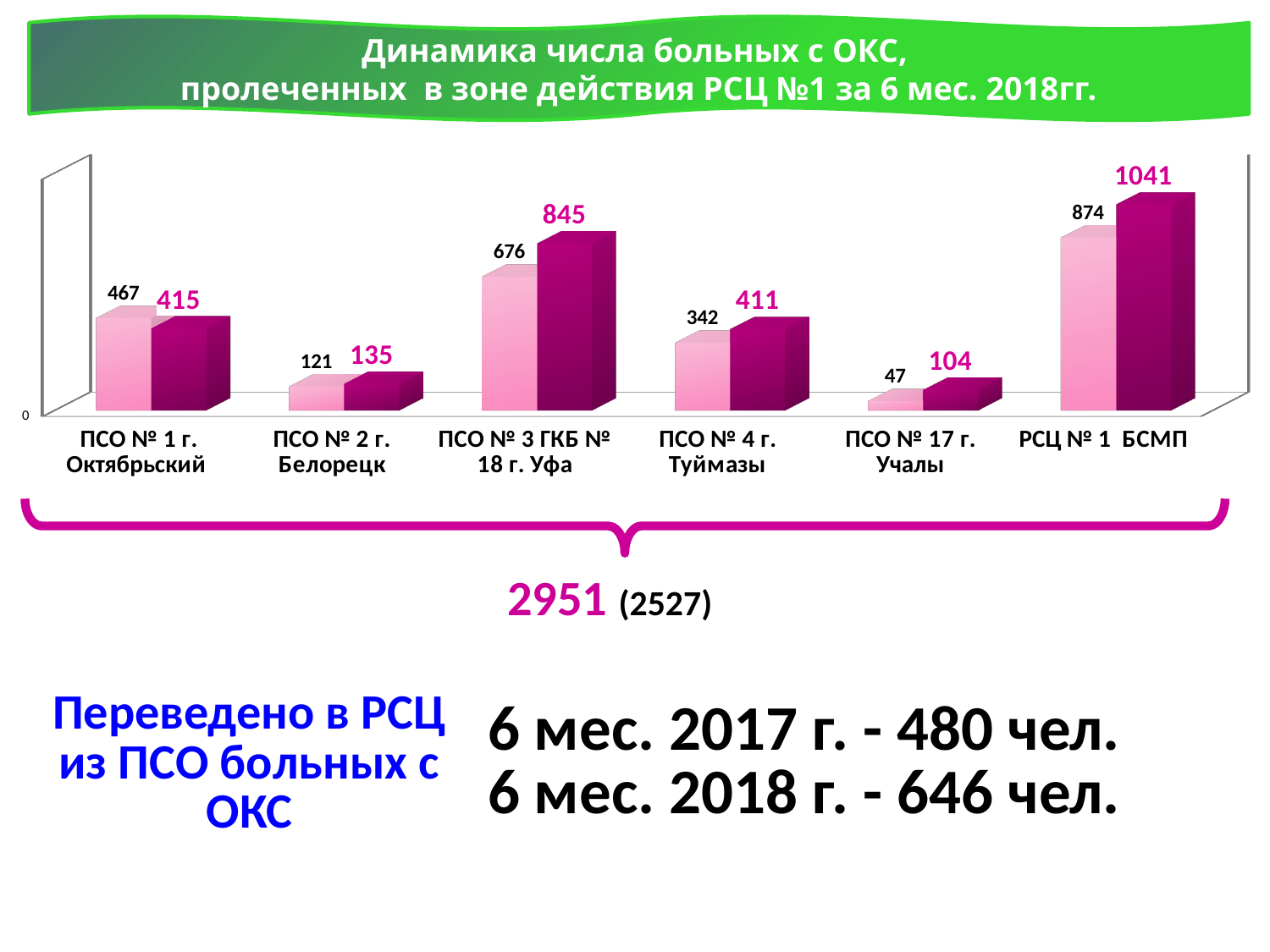
Which category has the lowest light pink bar? ПСО № 17 г. Учалы How many categories are shown on the x axis of the chart? 6 What is the value of the dark magenta bar for ПСО № 3 ГКБ № 18 г. Уфа? 845 Which category has the highest dark magenta bar? РСЦ № 1 БСМП What is the difference between the light pink bar for ПСО № 2 г. Белорецк and its dark magenta bar? 14 What is the value of the dark magenta bar for РСЦ № 1 БСМП? 1041 What is the value of the light pink bar for ПСО № 4 г. Туймазы? 342 What kind of chart is shown on the slide? bar chart What is the difference between the dark magenta and light pink bars for ПСО № 3 ГКБ № 18 г. Уфа? 169 What total is printed in magenta below the bracket under the chart? 2951 For ПСО № 1 г. Октябрьский, which is larger: the light pink bar or the dark magenta bar? the light pink bar What is the value of the light pink bar for ПСО № 17 г. Учалы? 47